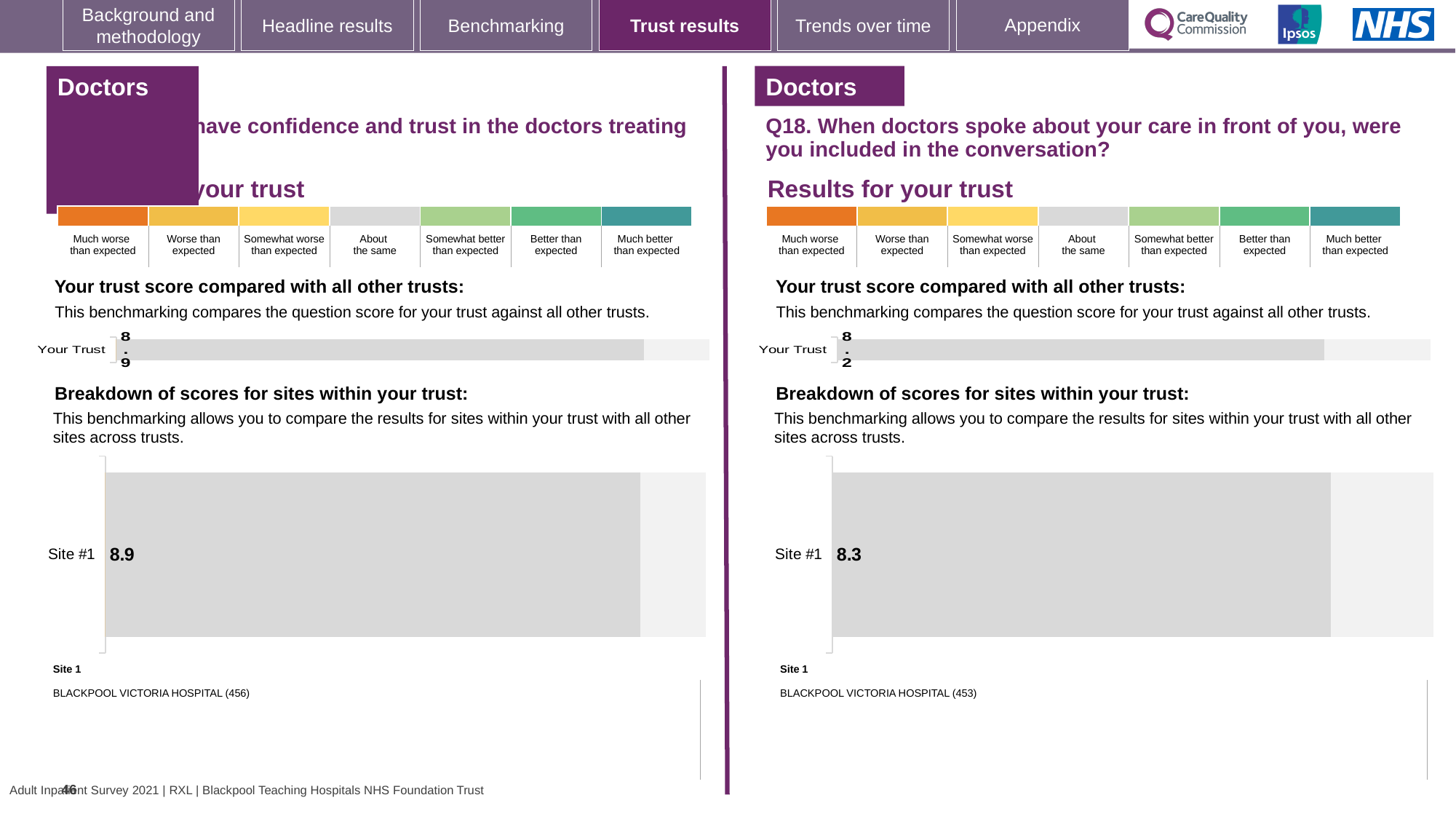
On the right half of the slide (Q18), what is the score shown for Your Trust? 8.2 Which site is listed as Site 1 on the left half of the slide? BLACKPOOL VICTORIA HOSPITAL (456) How many sites are shown in the site breakdown chart on the right half of the slide? 1 On the left half of the slide, what is the score shown for Site #1? 8.9 On the left half of the slide, what is the score shown for Your Trust? 8.9 On the right half of the slide (Q18), what is the score shown for Site #1? 8.3 What type of chart is used to show the Your Trust score on each half of the slide? Bar chart On the right half of the slide (Q18), what is the difference between the Site #1 score and the Your Trust score? 0.1 What is the question number shown in the title on the right half of the slide? Q18 Which is larger: the Your Trust score on the left half of the slide or the Your Trust score on the right half (Q18)? Left half (8.9) What is the difference between the Site #1 score on the left half of the slide and the Site #1 score on the right half (Q18)? 0.6